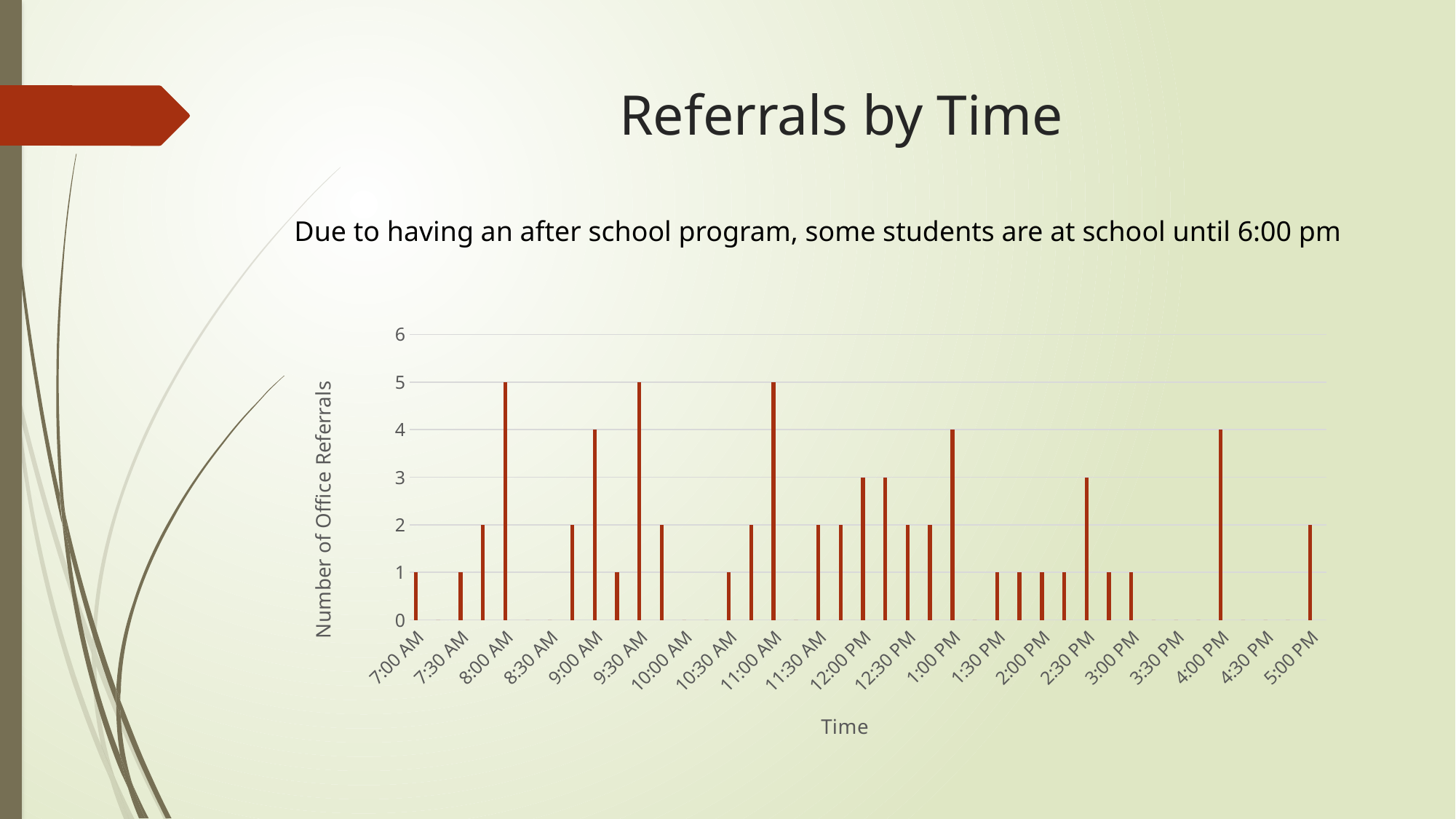
What is the label of the vertical axis of the chart? Number of Office Referrals Is the number of office referrals at 11:00 AM greater or less than 3? greater What is the highest number of office referrals reached by any bar in the chart? 5 Which time has more office referrals, 9:00 AM or 9:30 AM? 9:30 AM What is the label of the horizontal axis of the chart? Time What is the number of office referrals at 5:00 PM? 2 What is the number of office referrals at 7:00 AM? 1 What is the number of office referrals at 9:00 AM? 4 What is the difference in office referrals between 8:00 AM and 7:00 AM? 4 What is the number of office referrals at 12:00 PM? 3 What is the number of office referrals at 8:00 AM? 5 What kind of chart is shown on the slide? Bar chart